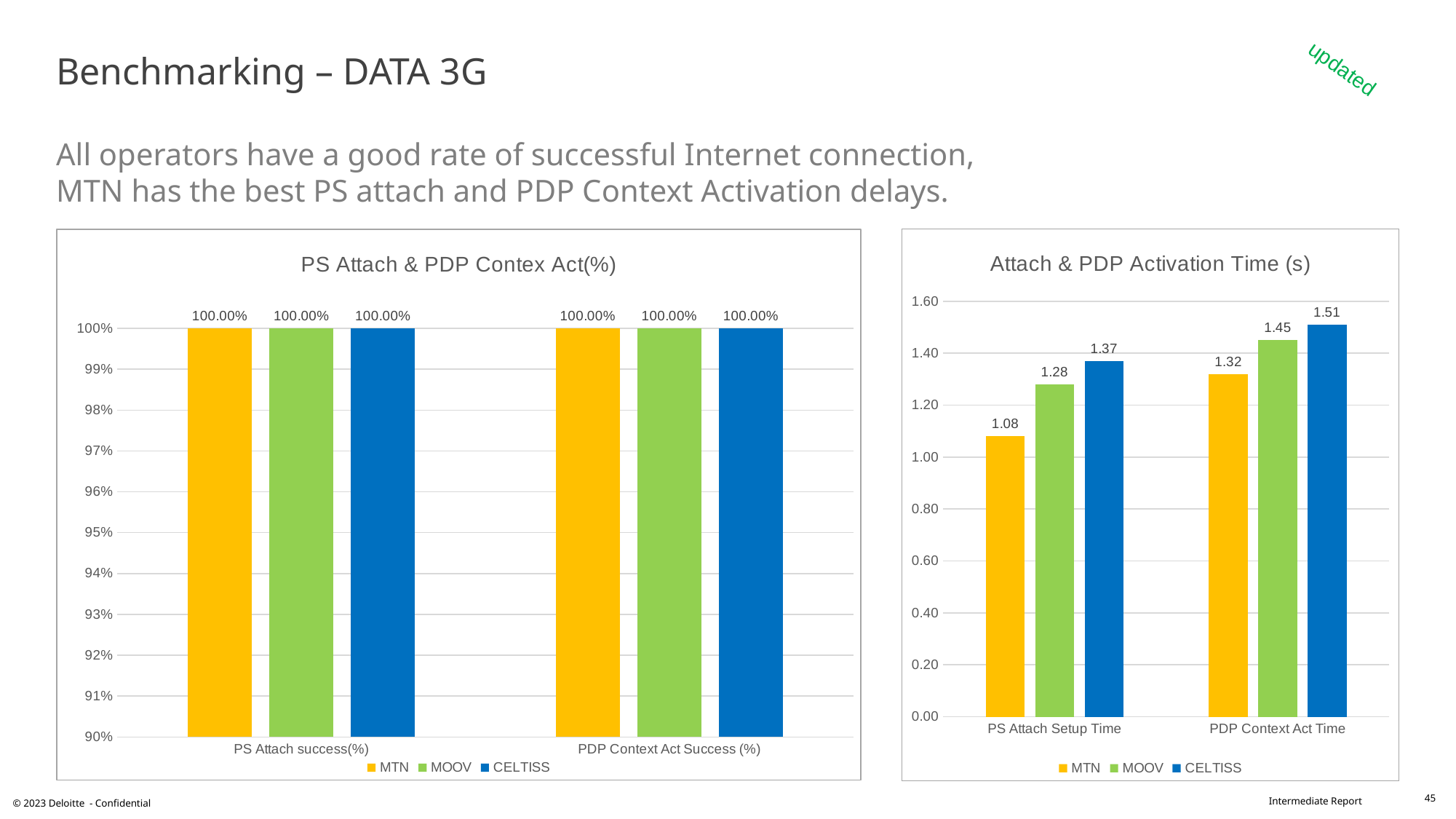
In the 'Attach & PDP Activation Time (s)' chart, what is the PDP Context Act Time for CELTISS? 1.51 In the 'PS Attach & PDP Contex Act(%)' chart, what is the PS Attach success value for MOOV? 100.00% In the 'Attach & PDP Activation Time (s)' chart, which operator has the highest PS Attach Setup Time? CELTISS How many series does the legend of the 'PS Attach & PDP Contex Act(%)' chart list? 3 What type of chart is the 'Attach & PDP Activation Time (s)' chart? Bar chart In the 'Attach & PDP Activation Time (s)' chart, what is the PS Attach Setup Time for MTN? 1.08 In the 'Attach & PDP Activation Time (s)' chart, what is the PDP Context Act Time for MOOV? 1.45 In the 'Attach & PDP Activation Time (s)' chart, which is larger: MOOV's PS Attach Setup Time or MOOV's PDP Context Act Time? PDP Context Act Time How many categories are shown on the x axis of the 'Attach & PDP Activation Time (s)' chart? 2 In the 'Attach & PDP Activation Time (s)' chart, what is the difference between the PS Attach Setup Time of CELTISS and MTN? 0.29 In the 'Attach & PDP Activation Time (s)' chart, which operator has the lowest PDP Context Act Time? MTN In the 'Attach & PDP Activation Time (s)' chart, is the PDP Context Act Time for MTN greater or less than 1.20? greater